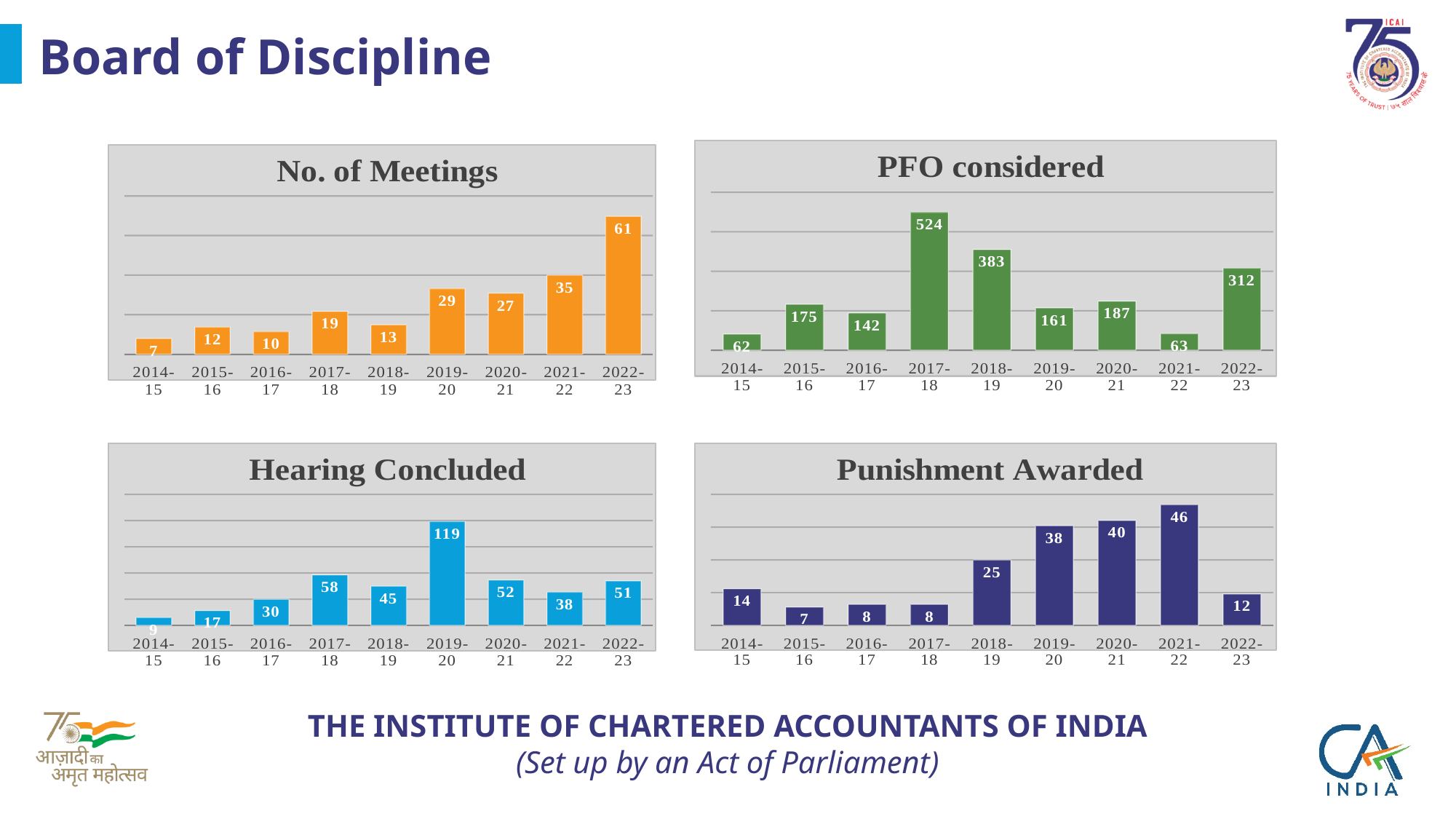
What type of chart is the 'PFO considered' chart? Bar chart How many years are shown on the x axis of the 'No. of Meetings' chart? 9 In the 'PFO considered' chart, which year has the lowest value? 2014-15 In the 'Hearing Concluded' chart, which year has the lowest value? 2014-15 In the 'No. of Meetings' chart, what is the value for 2022-23? 61 In the 'Punishment Awarded' chart, what is the value for 2021-22? 46 In the 'PFO considered' chart, what is the value for 2018-19? 383 In the 'Punishment Awarded' chart, which is larger, the value for 2019-20 or the value for 2022-23? 2019-20 What colour are the bars in the 'Hearing Concluded' chart? Blue In the 'PFO considered' chart, which year has the highest value? 2017-18 In the 'No. of Meetings' chart, what is the difference between the values for 2022-23 and 2021-22? 26 In the 'Hearing Concluded' chart, what is the difference between the values for 2019-20 and 2017-18? 61